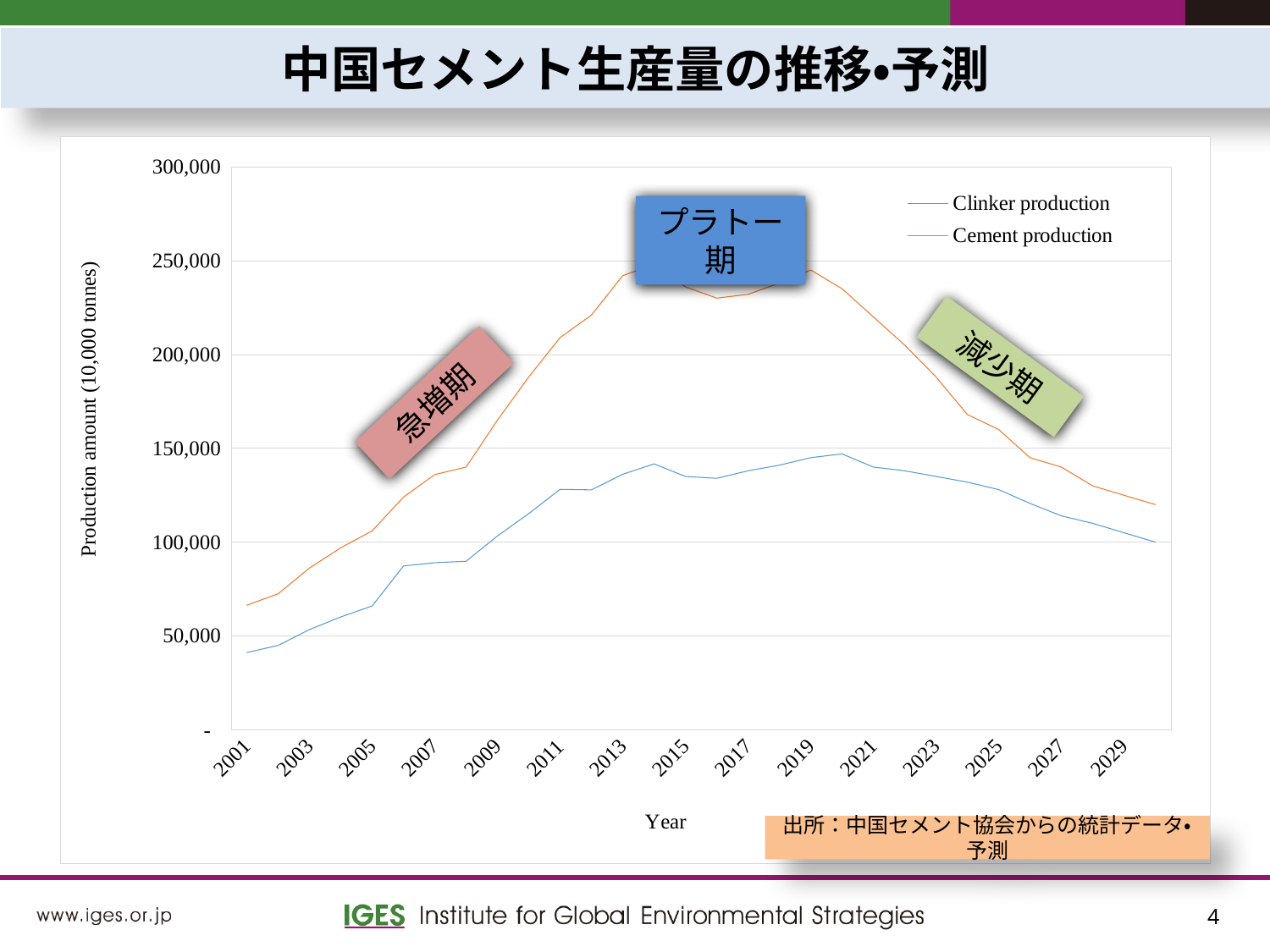
How many series does the legend list? 2 What kind of chart is shown on the slide? line chart Is the value for Cement production in 2029 greater or less than 150,000? less Is the value for Clinker production in 2019 greater or less than 100,000? greater Is the value for Cement production in 2019 greater or less than 200,000? greater What are the two series named in the legend? Clinker production and Cement production Does Cement production rise or fall between 2001 and 2013? rise In 2015, which series has the higher value, Clinker production or Cement production? Cement production Does Clinker production rise or fall between 2019 and 2029? fall What is the label of the vertical axis? Production amount (10,000 tonnes)